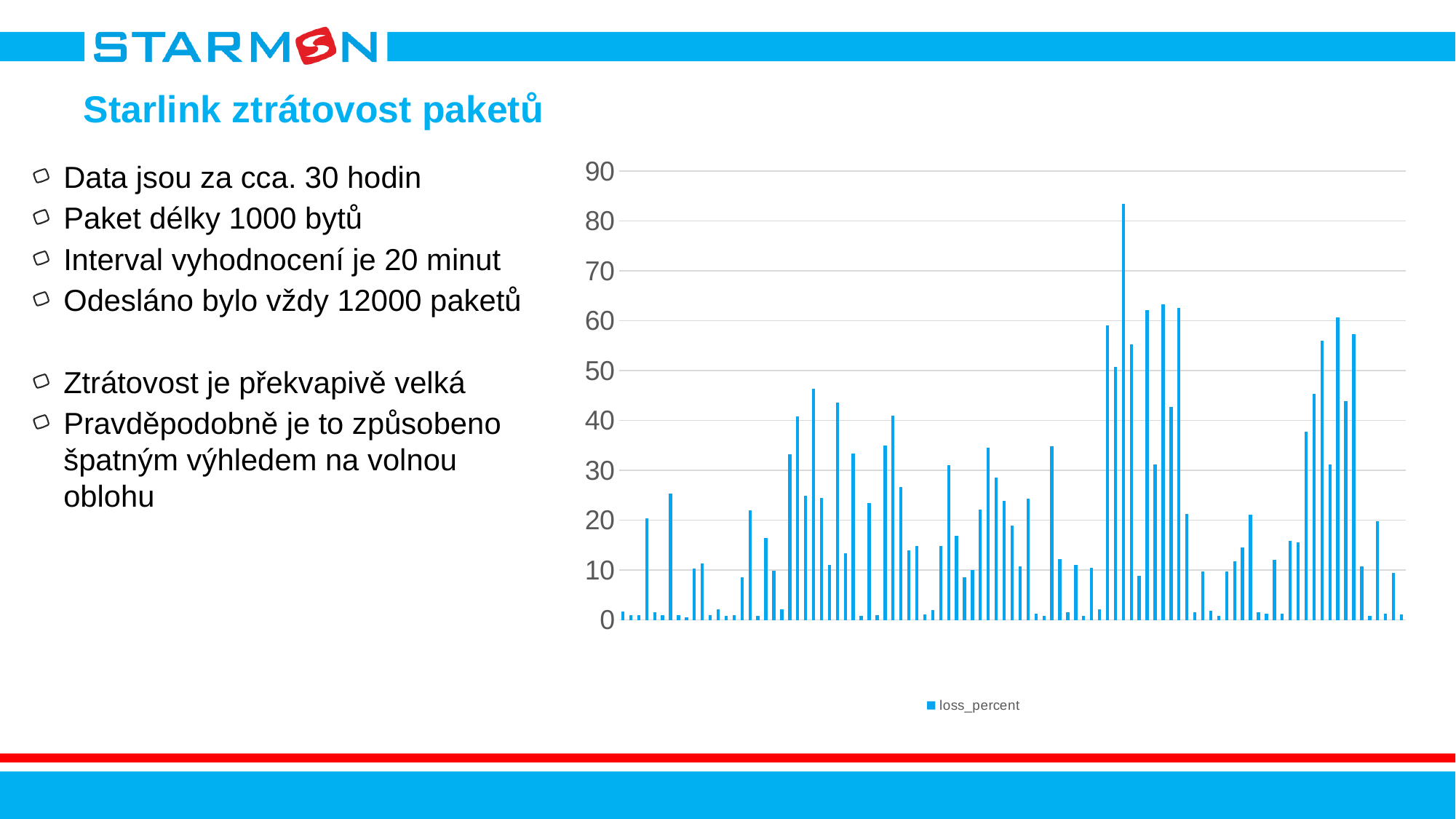
How many series does the chart legend list? 1 What is the highest value shown on the vertical axis of the chart? 90 Is the value of the tallest bar in the chart greater or less than 90? less What kind of chart is shown on the slide? bar chart What is the name of the series shown in the chart legend? loss_percent Is the value of the tallest bar in the chart greater or less than 80? greater